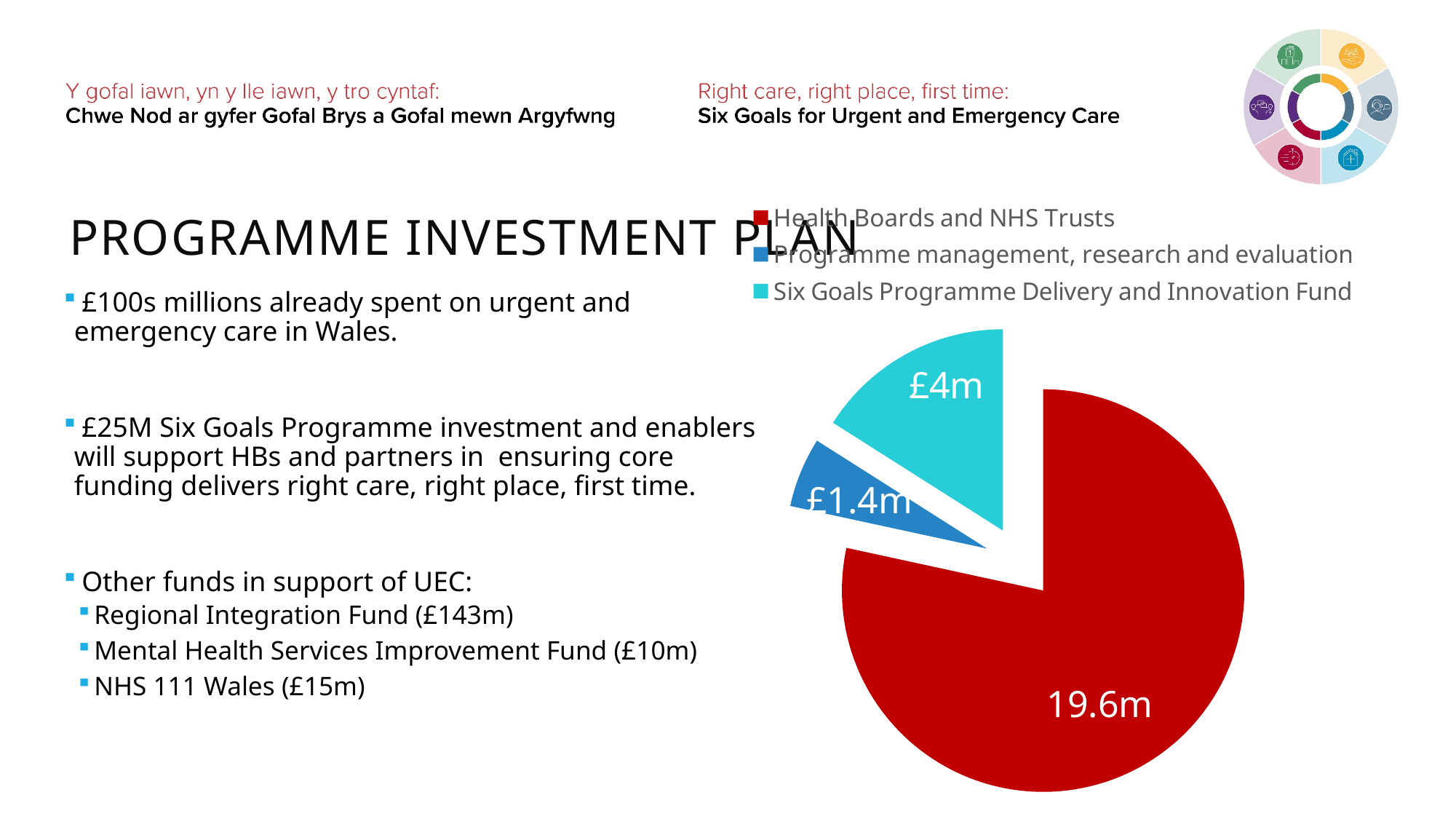
What is the value shown for the Health Boards and NHS Trusts slice? 19.6m What colour is the Health Boards and NHS Trusts slice? red How many slices does the pie chart have? 3 Which category has the smallest slice of the pie? Programme management, research and evaluation Which category has the largest slice of the pie? Health Boards and NHS Trusts What is the difference between the Six Goals Programme Delivery and Innovation Fund value and the Programme management, research and evaluation value? £2.6m What is the value shown for the Programme management, research and evaluation slice? £1.4m What share of the pie does the Six Goals Programme Delivery and Innovation Fund slice represent? 16% What is the value shown for the Six Goals Programme Delivery and Innovation Fund slice? £4m How many entries does the legend list? 3 What kind of chart is shown on the slide? pie chart Which is larger: the Six Goals Programme Delivery and Innovation Fund slice or the Programme management, research and evaluation slice? Six Goals Programme Delivery and Innovation Fund